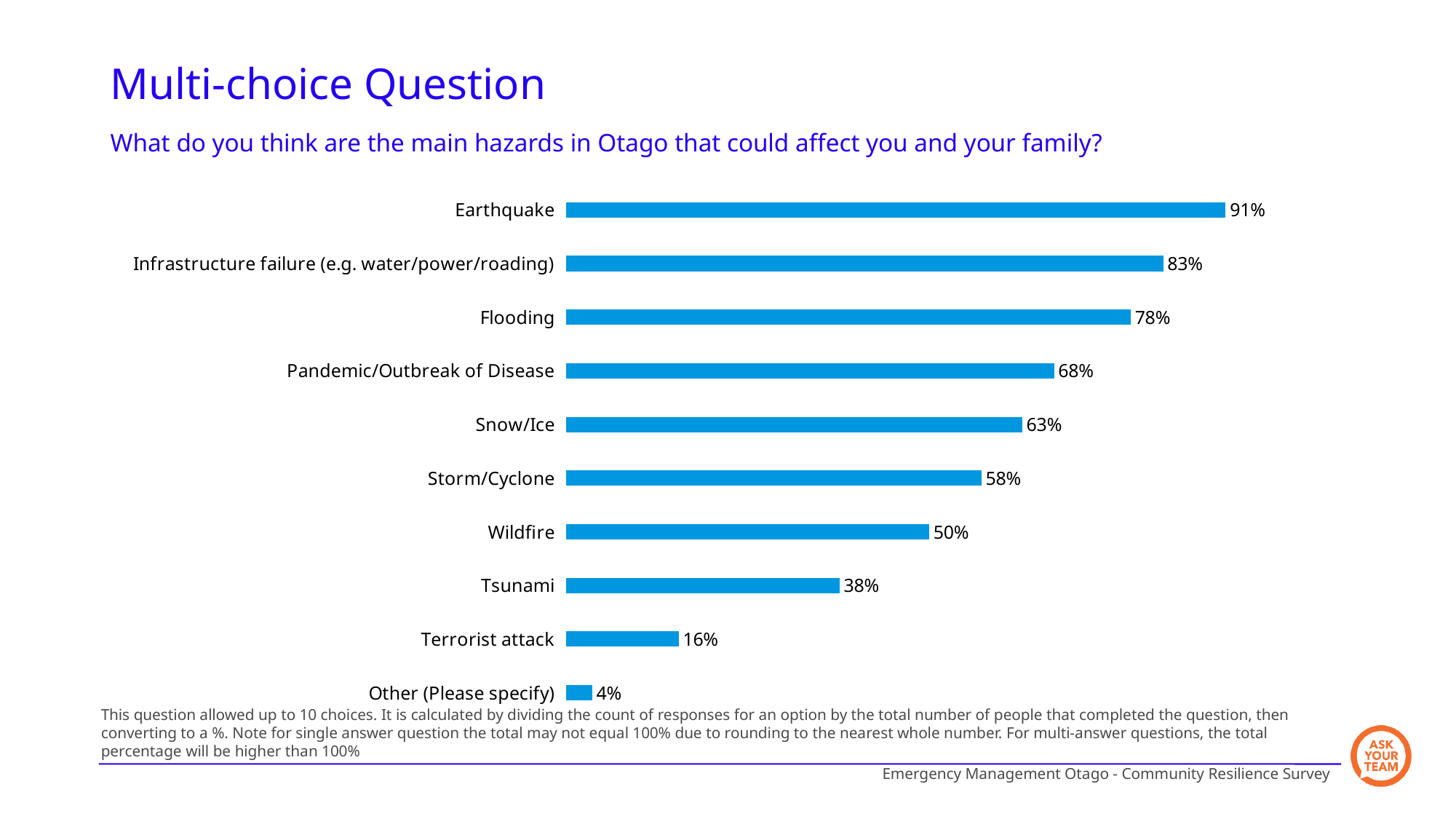
Which hazard has the highest percentage? Earthquake What colour are the bars in the chart? Blue What is the difference between Infrastructure failure (e.g. water/power/roading) and Snow/Ice? 20% What percentage of respondents selected Earthquake as a main hazard? 91% Which has a higher percentage, Storm/Cyclone or Snow/Ice? Snow/Ice How many hazard categories are shown in the chart? 10 What is the difference between the percentages for Flooding and Wildfire? 28% What is the value shown for Pandemic/Outbreak of Disease? 68% Which has a higher percentage, Terrorist attack or Tsunami? Tsunami What percentage is shown for Tsunami? 38% Which category has the lowest percentage? Other (Please specify) What type of chart is shown on the slide? Bar chart